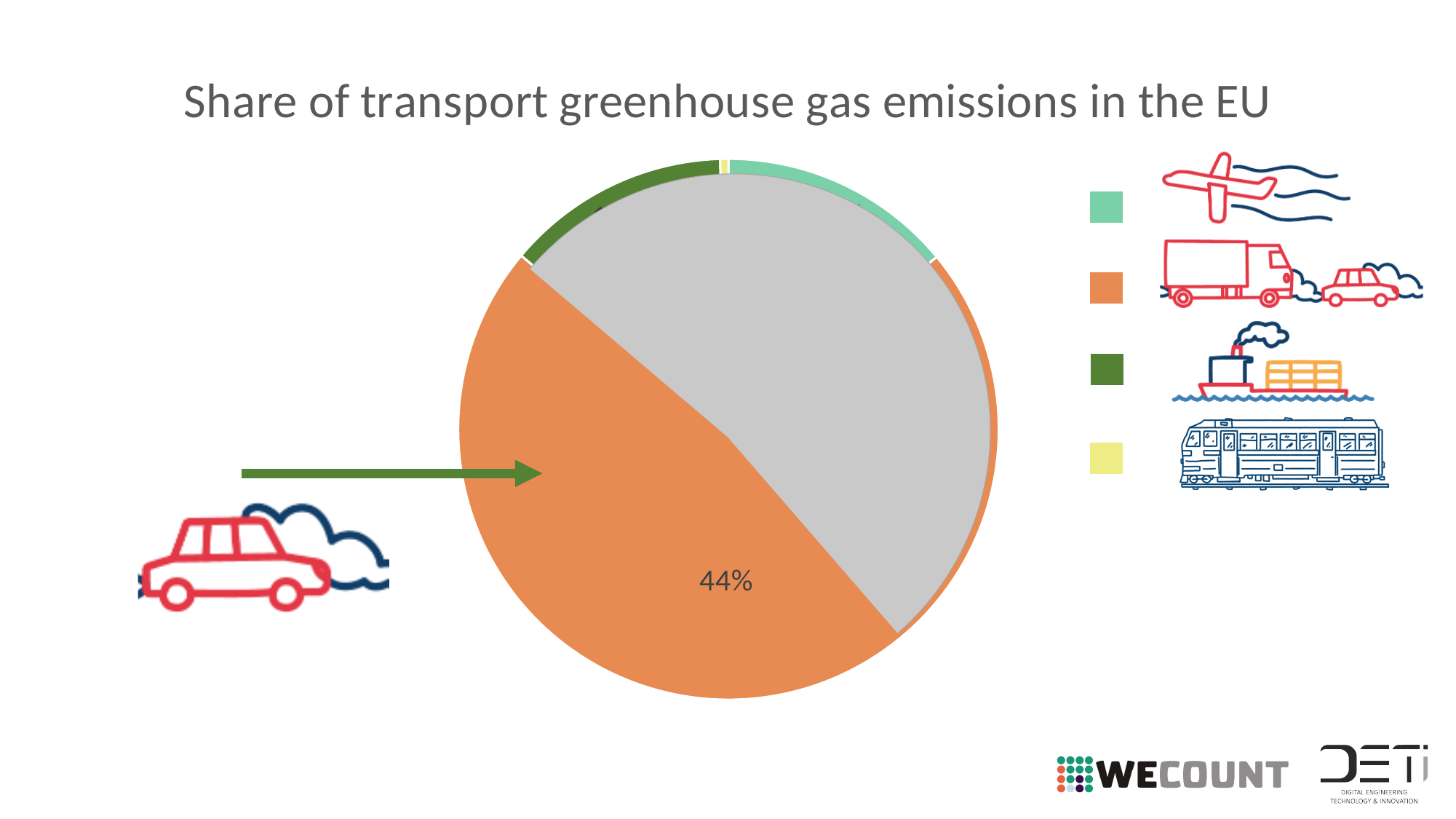
What kind of chart is shown on the slide? pie chart How many colour entries does the legend list? 4 Which is larger, the orange slice or the light green slice? orange Which coloured slice is the largest in the pie chart? orange What share of the pie does the orange slice (the one with the truck and car icon in the legend) represent? 44% What is the title of the chart? Share of transport greenhouse gas emissions in the EU What percentage is printed on the orange slice of the pie chart? 44% Which is larger, the dark green slice or the yellow slice? dark green Which legend entry is shown with an aeroplane icon? the light green entry Which coloured slice is the smallest in the pie chart? yellow